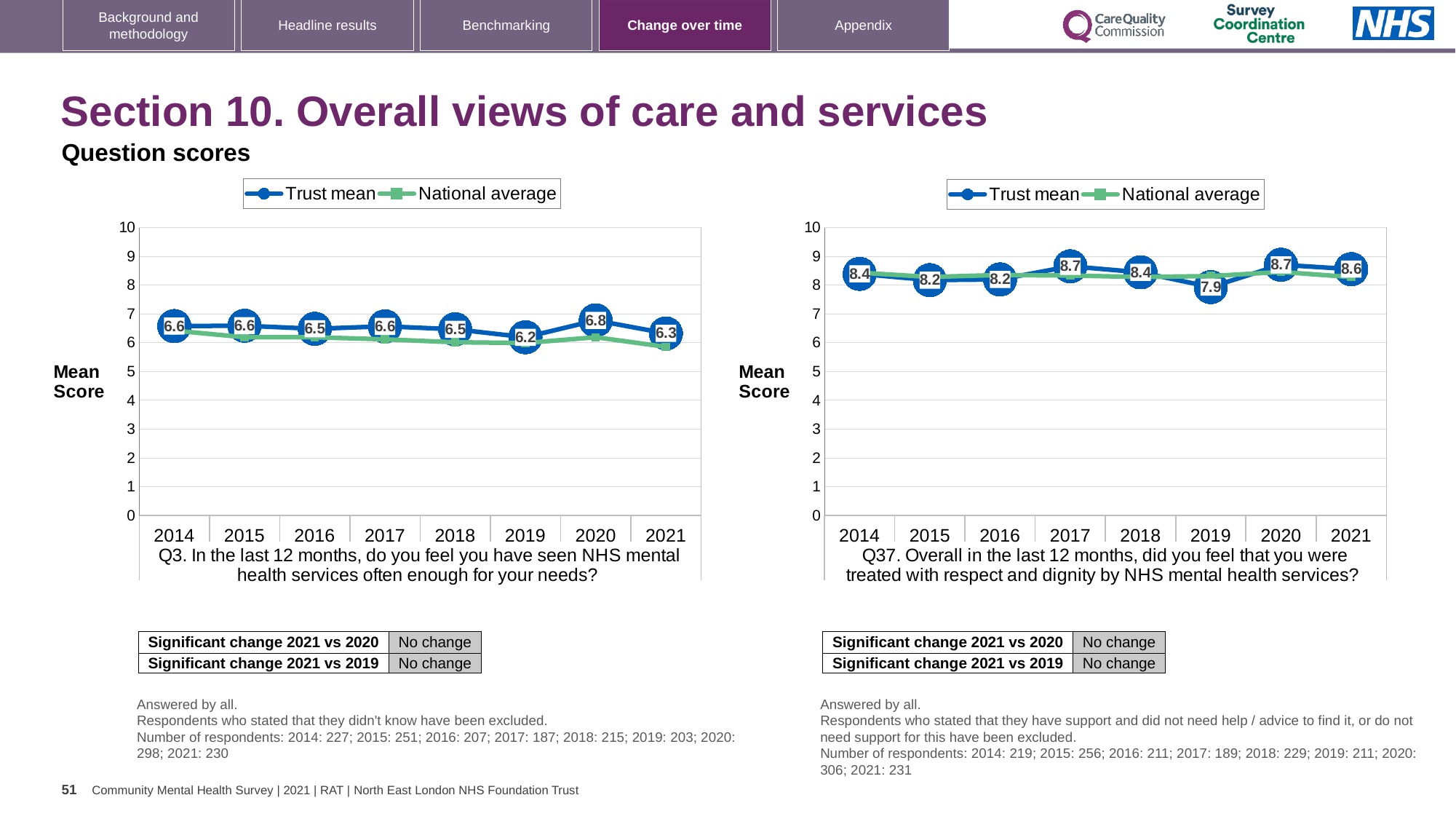
In the Q3 chart on the left, is the National average for 2021 greater or less than 7? less In the Q3 chart on the left, what is the difference between the Trust mean scores for 2020 and 2021? 0.5 In the Q37 chart on the right, what is the difference between the Trust mean scores for 2020 and 2019? 0.8 How many years are shown on the x axis of the Q37 chart on the right? 8 In the Q3 chart on the left, what is the Trust mean score for 2021? 6.3 In the Q3 chart on the left, which year has the highest Trust mean score? 2020 In the Q3 chart on the left, what is the Trust mean score for 2020? 6.8 In the Q3 chart on the left, which year has the lowest Trust mean score? 2019 How many series does the legend of the Q3 chart on the left list? 2 In the Q37 chart on the right, what is the Trust mean score for 2019? 7.9 In the Q37 chart on the right, which is larger, the Trust mean for 2017 or the Trust mean for 2018? 2017 In the Q37 chart on the right, which year has the lowest Trust mean score? 2019